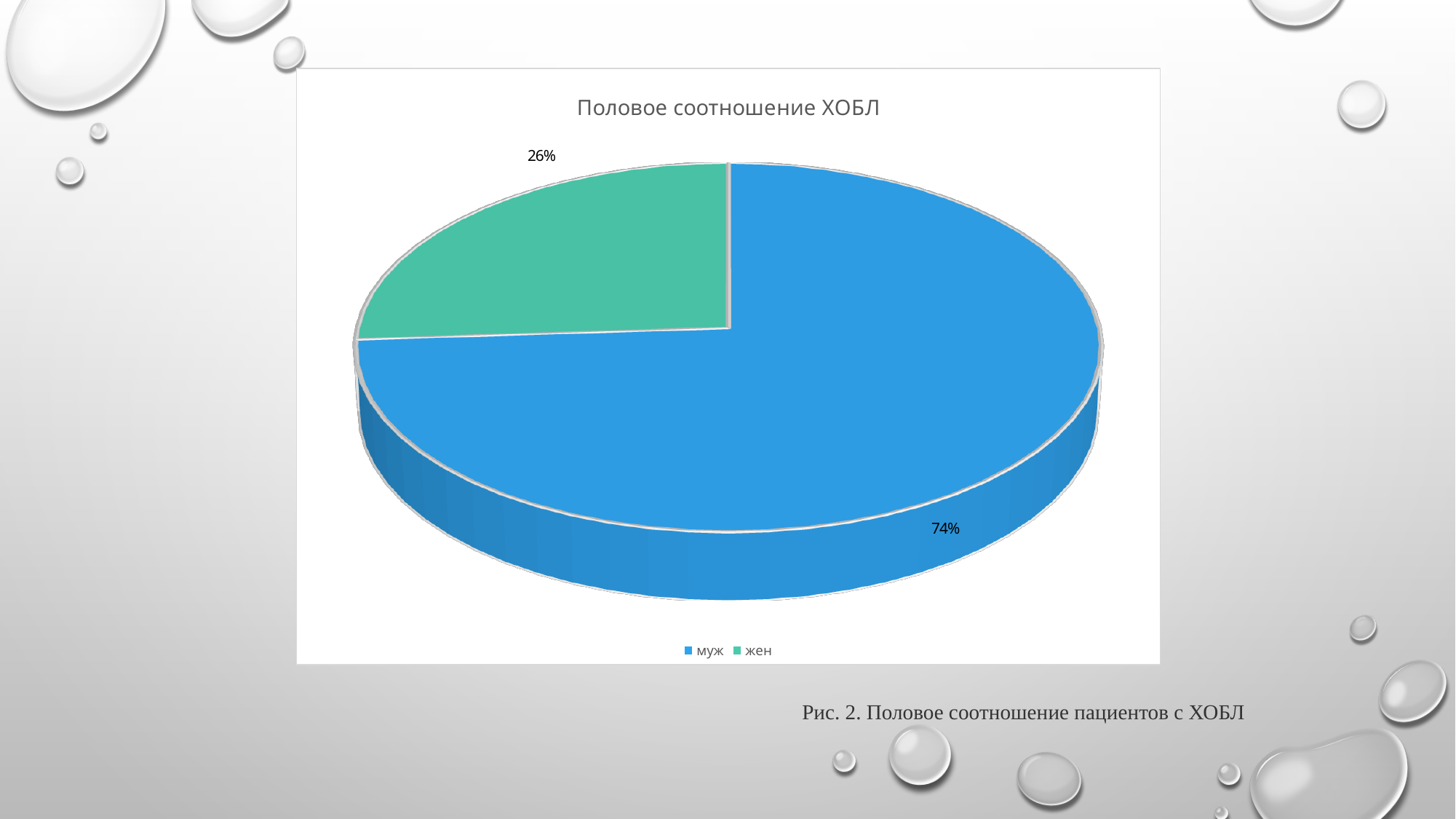
What share of the pie does the 'жен' slice represent? 26% What is the chart's title? Половое соотношение ХОБЛ What share of the pie does the 'муж' slice represent? 74% Which slice is larger, 'муж' or 'жен'? муж How many slices does the pie chart have? 2 What is the difference in percentage points between the 'муж' and 'жен' slices? 48% How many entries does the legend list? 2 Which category has the largest slice of the pie? муж Which category has the smallest slice of the pie? жен What colour is the 'жен' slice? green What kind of chart is shown on the slide? pie chart